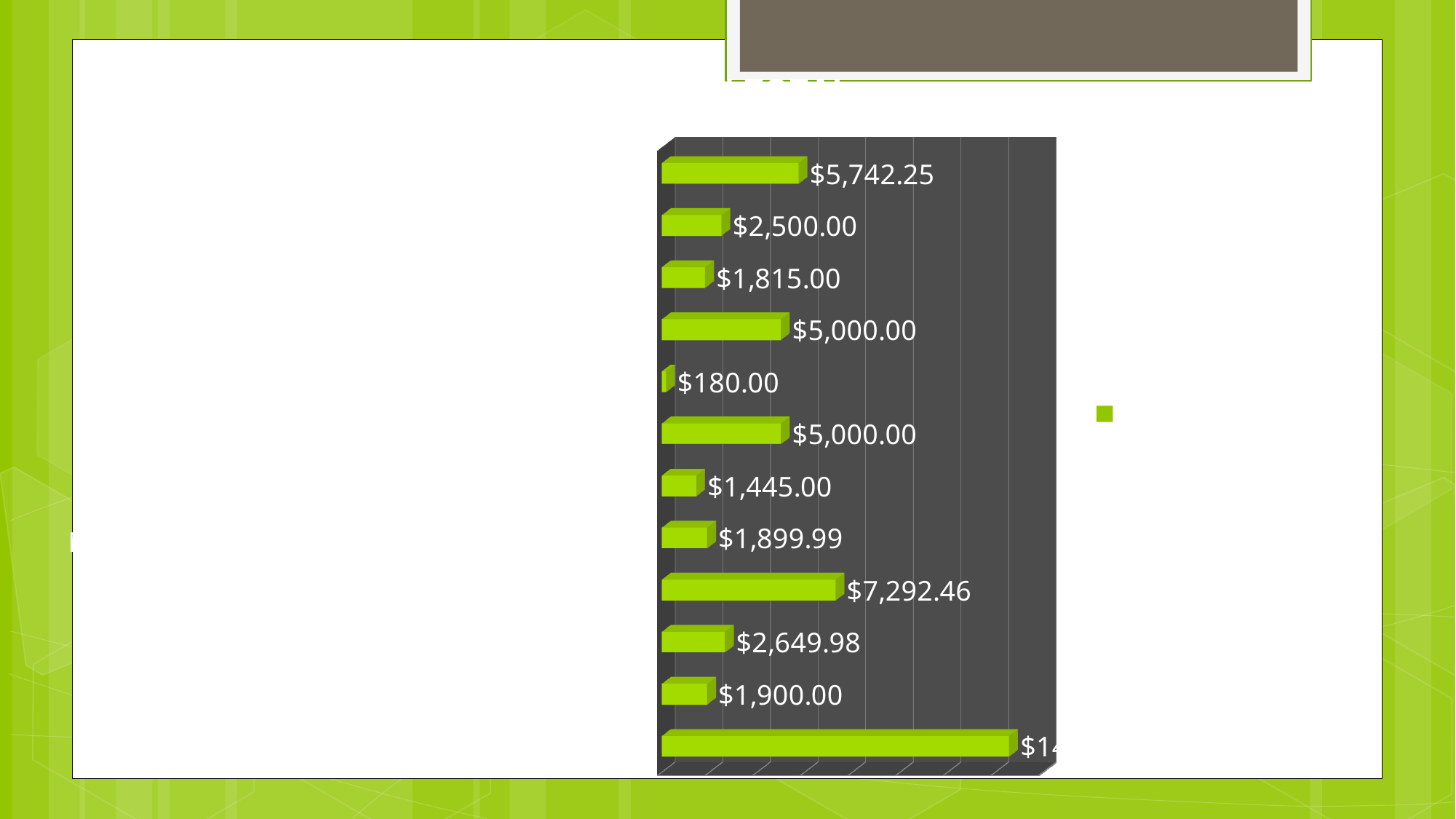
Which bar is the longest in the chart? the bottom bar What is the value labelled on the top bar of the chart? $5,742.25 What is the value labelled on the second bar from the top? $2,500.00 What is the value labelled on the ninth bar from the top? $7,292.46 What kind of chart is shown on the slide? bar chart What is the difference between the bar labelled $7,292.46 and a bar labelled $5,000.00? $2,292.46 What is the difference between the top bar ($5,742.25) and the second bar ($2,500.00)? $3,242.25 What is the value labelled on the fifth bar from the top? $180.00 Which is larger: the third bar from the top ($1,815.00) or the eighth bar from the top ($1,899.99)? the eighth bar ($1,899.99) What colour are the bars in the chart? green How many bars does the chart contain? 12 Which bar has the smallest value in the chart? the fifth bar from the top ($180.00)